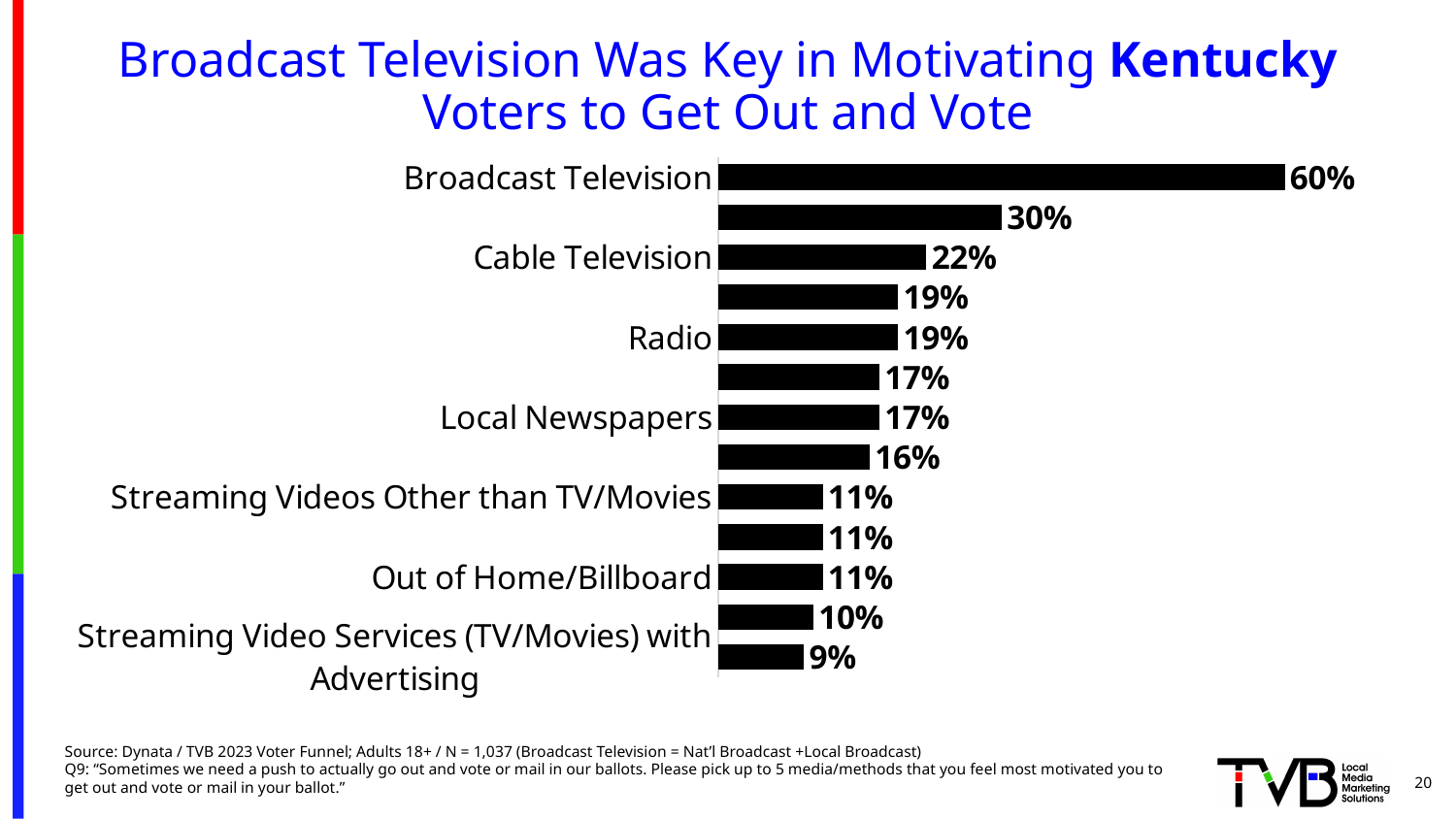
Which has a larger value, Radio or Local Newspapers? Radio Which category has the highest value in the chart? Broadcast Television How many bars are plotted in the chart? 13 Which labeled category has the lowest value in the chart? Streaming Video Services (TV/Movies) with Advertising What is the value shown for Streaming Video Services (TV/Movies) with Advertising? 9% What is the value shown for Radio? 19% What is the value shown for Local Newspapers? 17% How many percentage points higher is Broadcast Television than Cable Television? 38 percentage points What percentage of Kentucky voters said Broadcast Television motivated them to get out and vote? 60% What is the value shown for Cable Television? 22% Do the bar values increase or decrease going from the top of the chart to the bottom? Decrease What kind of chart is shown on the slide? Bar chart